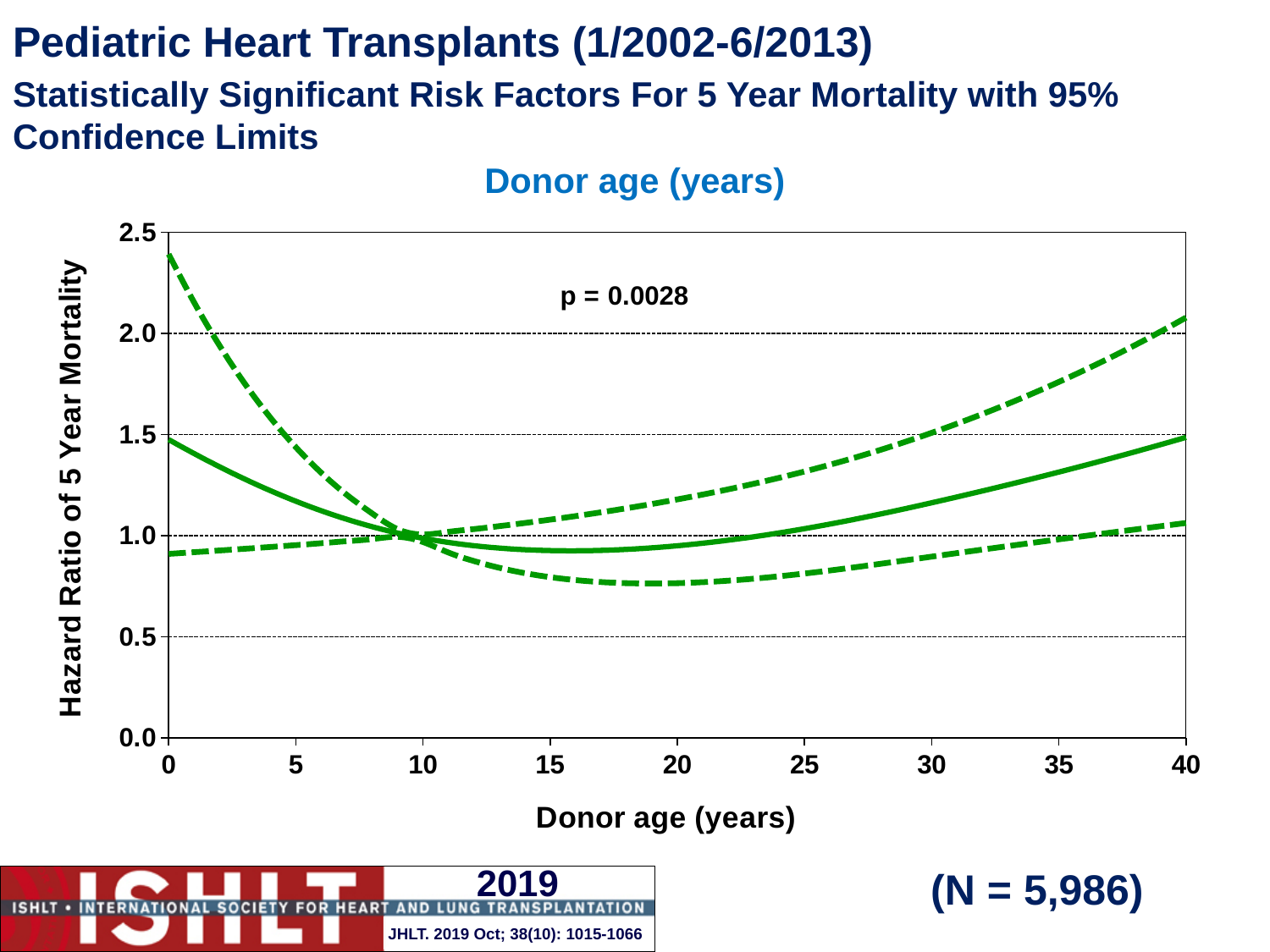
Is the value of the solid line at donor age 30 greater or less than 1.0? greater How many curves are plotted on the chart? 3 What kind of chart is shown on the slide? line chart Is the value of the upper dashed line at donor age 0 greater or less than 2.0? greater Is the value of the upper dashed line at donor age 35 greater or less than 1.5? greater Between donor age 0 and donor age 10, does the solid line rise or fall? fall What p-value is printed on the chart? p = 0.0028 What is the label of the y axis? Hazard Ratio of 5 Year Mortality Between donor age 25 and donor age 40, does the solid line rise or fall? rise